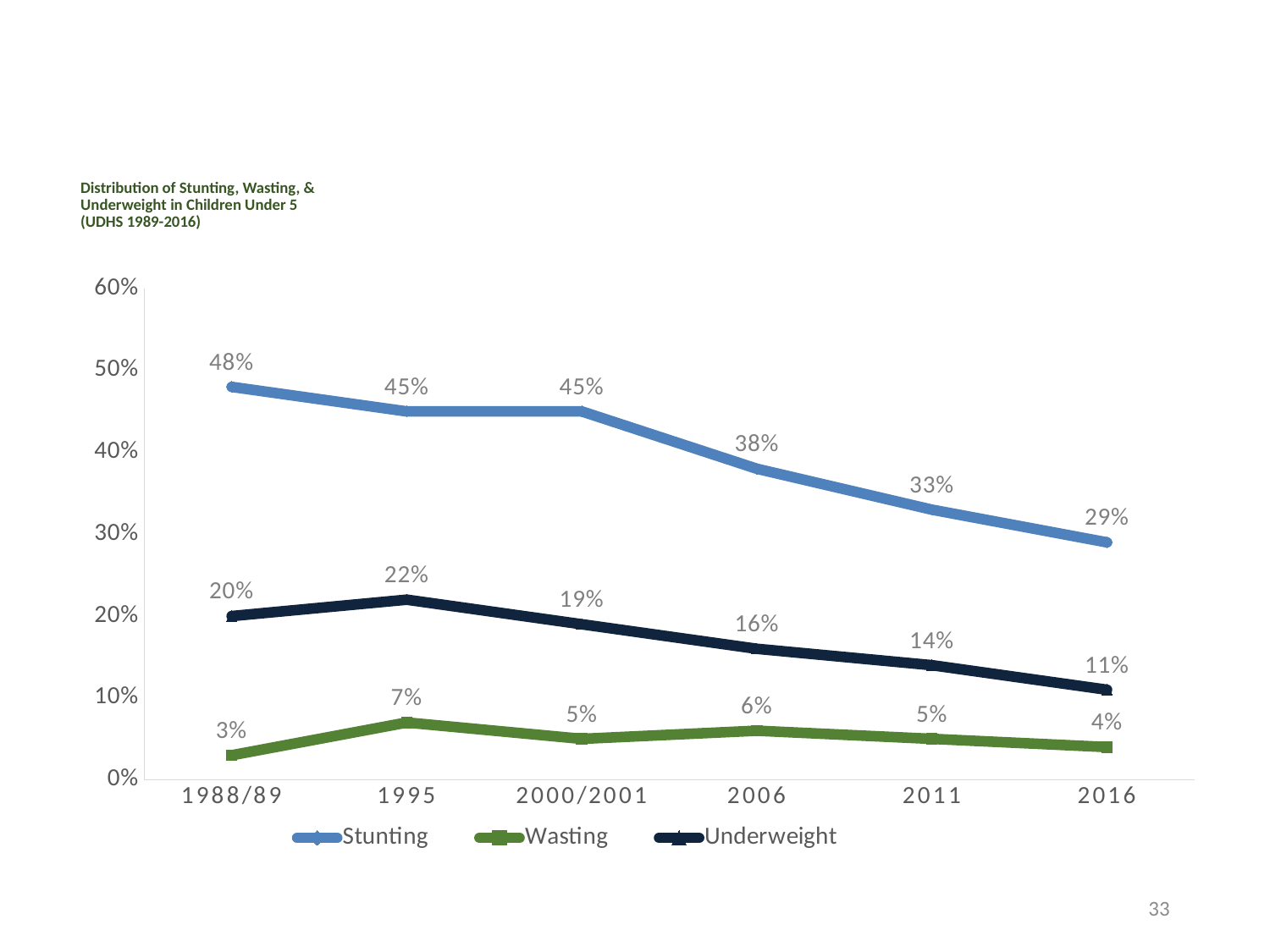
What is the difference between the Stunting values for 1988/89 and 2016? 19% What is the Stunting value for 2016? 29% What kind of chart is shown? line chart What is the Underweight value for 1995? 22% In which year is Stunting highest? 1988/89 How many survey years are shown on the x axis? 6 Does the Underweight series rise or fall from 1995 to 2016? fall In which year is Wasting lowest? 1988/89 Is the Stunting value for 2006 greater or less than 40%? less How many series does the legend list? 3 What is the Wasting value for 2006? 6% Which is larger, Underweight in 2000/2001 or Underweight in 2011? 2000/2001